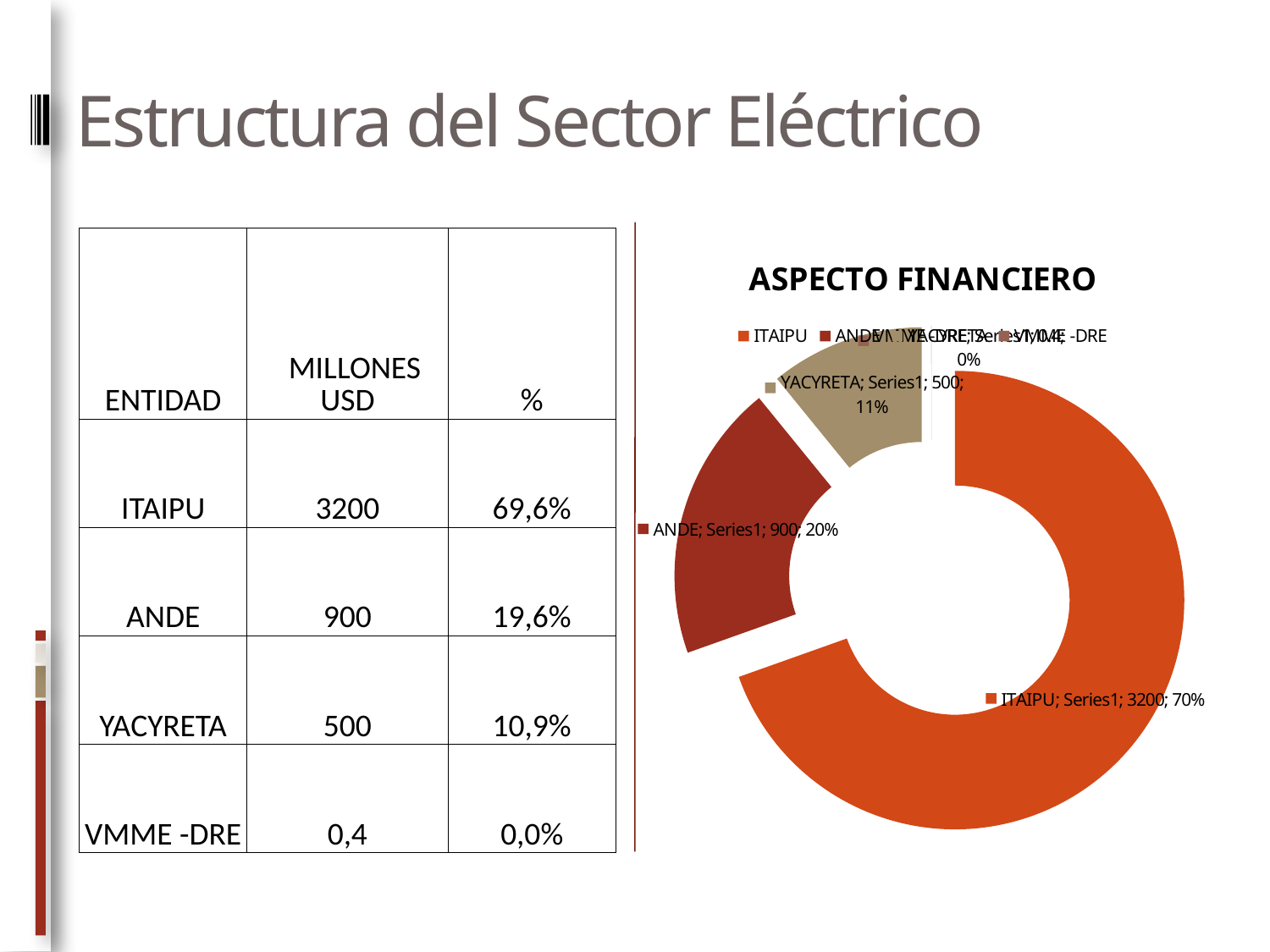
What is the value shown for ANDE in the ASPECTO FINANCIERO chart? 900 What percentage share does ITAIPU have in the ASPECTO FINANCIERO chart? 70% Which entity has the smallest slice in the ASPECTO FINANCIERO chart? VMME -DRE In the ASPECTO FINANCIERO chart, what is the difference between the values for ITAIPU and ANDE? 2300 What is the value shown for ITAIPU in the ASPECTO FINANCIERO chart? 3200 In the ASPECTO FINANCIERO chart, which is larger, the value for ANDE or the value for YACYRETA? ANDE Which entity has the largest slice in the ASPECTO FINANCIERO chart? ITAIPU What type of chart is shown under the title ASPECTO FINANCIERO? Doughnut chart What percentage share does YACYRETA have in the ASPECTO FINANCIERO chart? 11% What is the value shown for YACYRETA in the ASPECTO FINANCIERO chart? 500 What percentage share does ANDE have in the ASPECTO FINANCIERO chart? 20% How many entities are listed in the legend of the ASPECTO FINANCIERO chart? 4